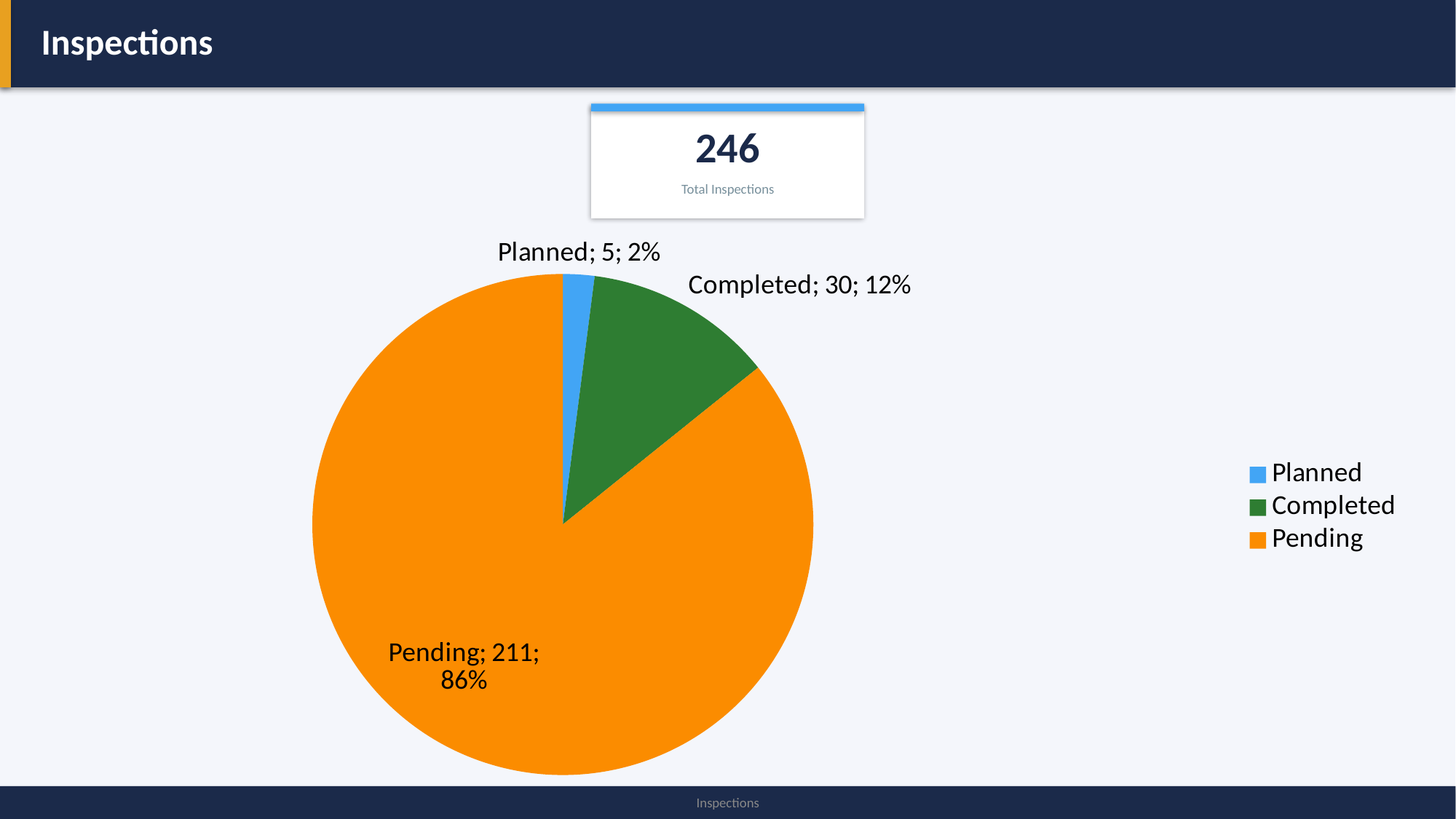
How many entries does the legend list? 3 What is the value for Planned? 5 What is the value for Pending? 211 How many slices does the pie chart have? 3 What colour is the Completed slice? green What share of the pie does Pending represent? 86% What is the value for Completed? 30 Which category has the largest slice? Pending What kind of chart is shown on the slide? pie chart What is the difference between the Pending and Completed values? 181 Which category has the smallest slice? Planned What share of the pie does Completed represent? 12%